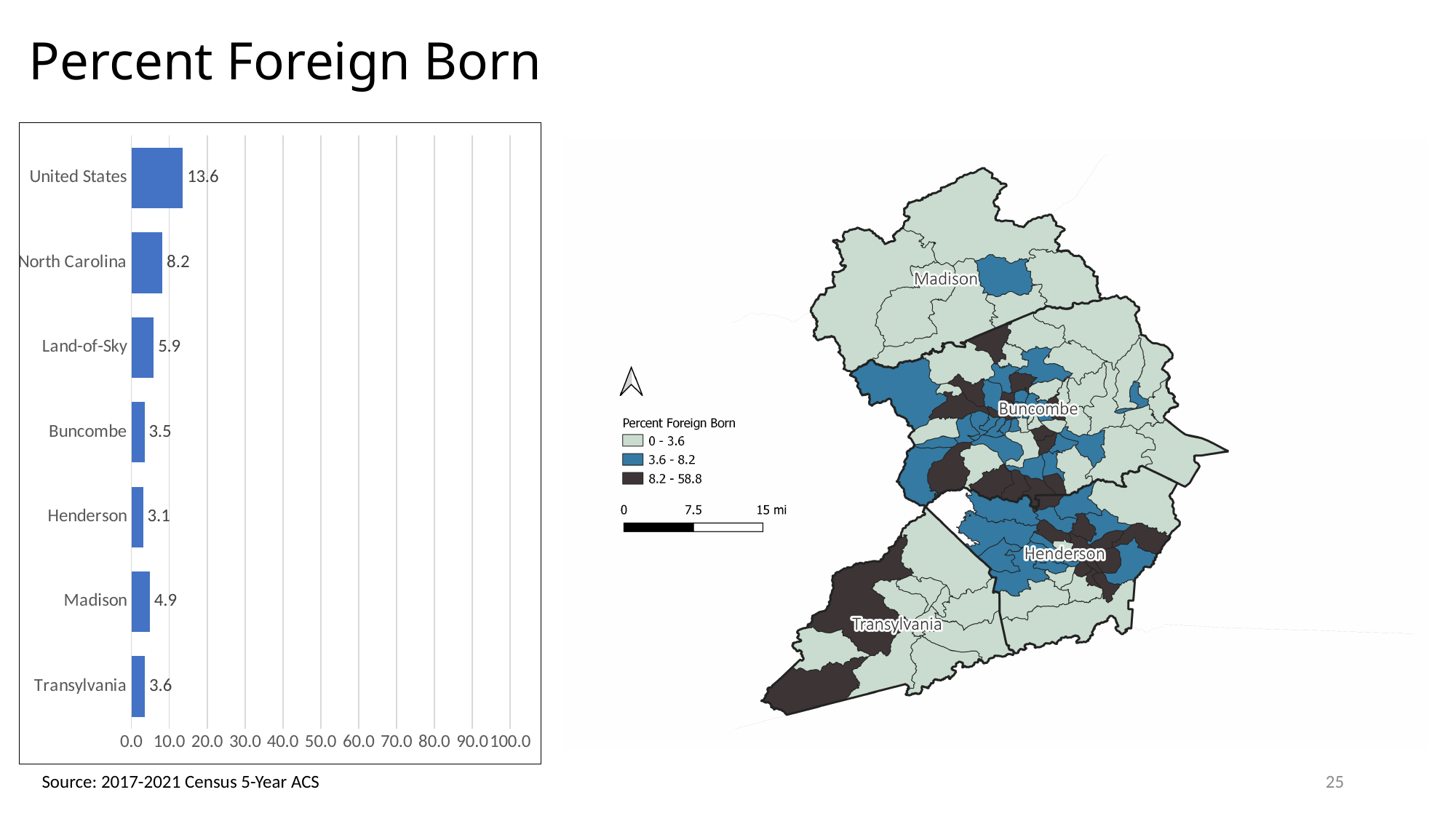
What is the maximum value shown on the x axis of the bar chart? 100.0 What is the value for United States in the bar chart? 13.6 What is the value for Land-of-Sky in the bar chart? 5.9 Which category has the highest value in the bar chart? United States Which category has the lowest value in the bar chart? Henderson Is the value for North Carolina in the bar chart greater or less than 10.0? less How many categories are shown in the bar chart? 7 What is the difference between the values for Madison and Transylvania in the bar chart? 1.3 What kind of chart is shown on the left of the slide? bar chart Which has a larger value in the bar chart, Madison or Buncombe? Madison What is the difference between the values for United States and North Carolina in the bar chart? 5.4 What is the value for Henderson in the bar chart? 3.1